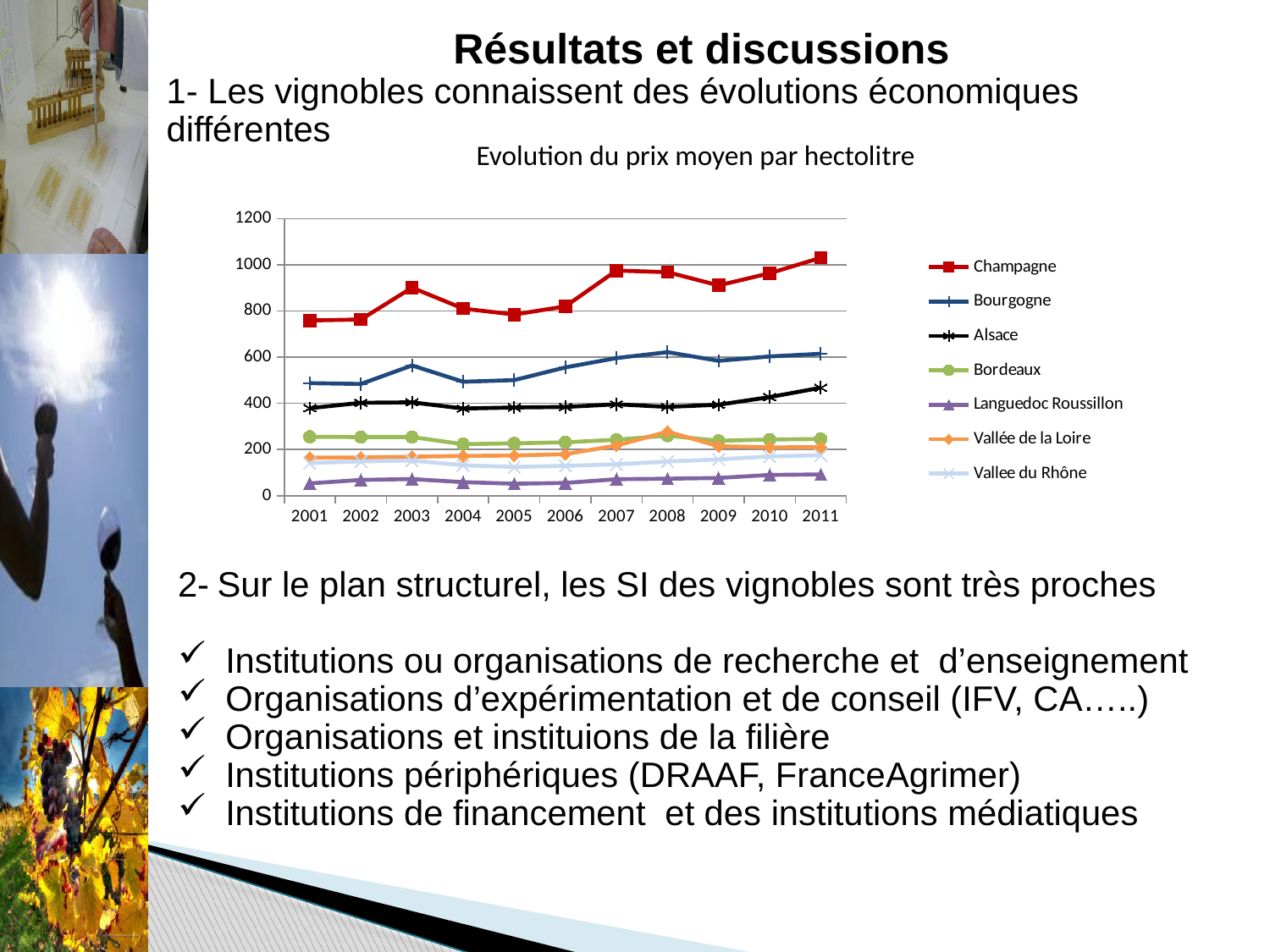
How many series does the chart's legend list? 7 How many years are shown on the x axis of the chart? 11 Which series has the lowest values throughout the chart? Languedoc Roussillon Is the value for Champagne in 2001 greater or less than 800? less Is the value for Champagne in 2011 greater or less than 1000? greater Is the value for Bourgogne in 2008 greater or less than 600? greater Which series has the highest values throughout the chart? Champagne Does the Champagne series rise or fall overall from 2001 to 2011? rise What is the title of the chart? Evolution du prix moyen par hectolitre Which is larger in 2011, the value for Champagne or the value for Bourgogne? Champagne What kind of chart is shown on the slide? Line chart